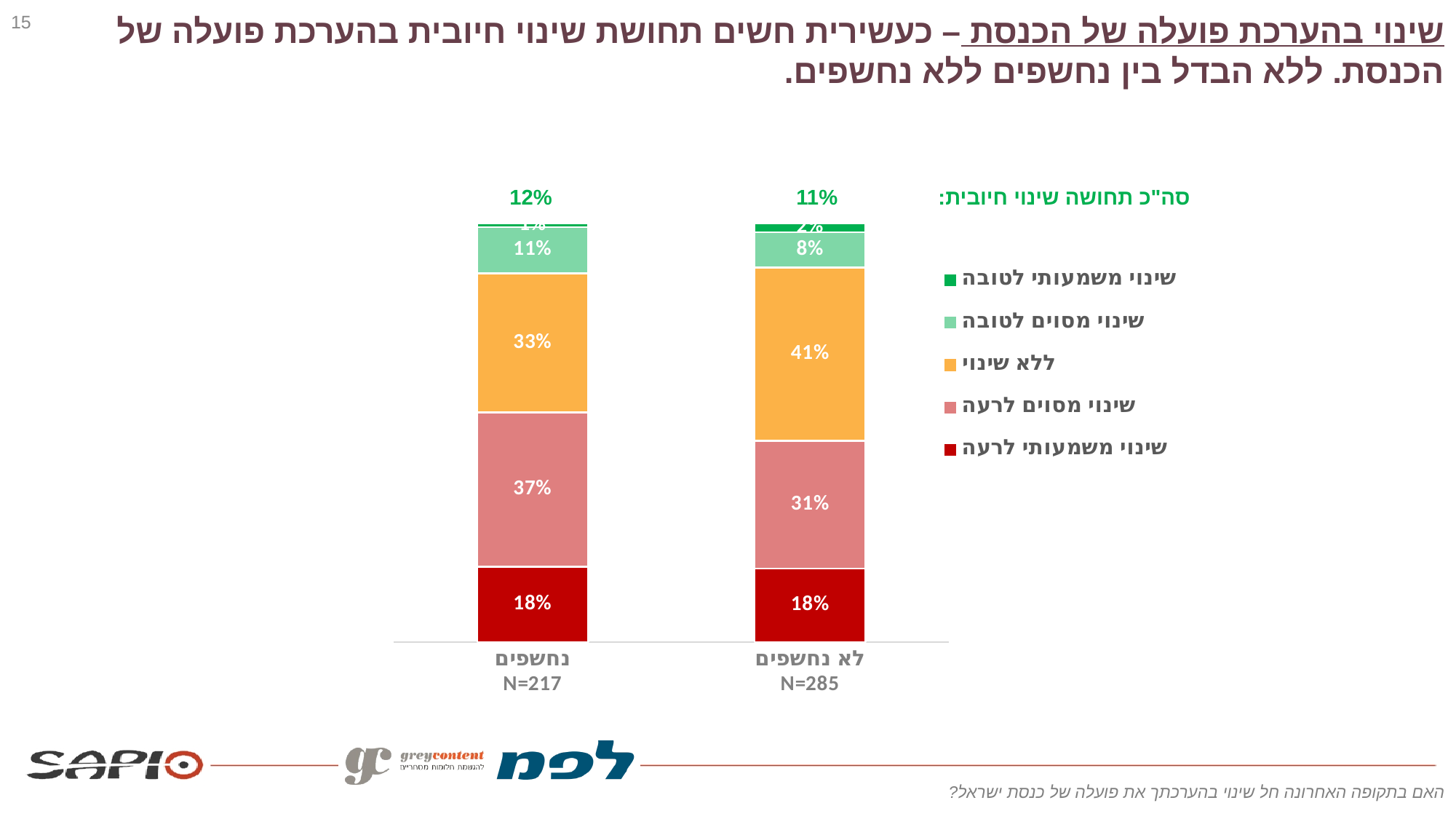
Which group has the larger value for שינוי מסוים לרעה, נחשפים or לא נחשפים? נחשפים What kind of chart is shown on the slide? stacked bar chart How many categories (bars) are shown on the x axis? 2 What is the value of שינוי מסוים לרעה for נחשפים? 37% What is the difference between the ללא שינוי values for לא נחשפים and נחשפים? 8% What is the total positive-change share (סה"כ תחושה שינוי חיובית) shown above the נחשפים bar? 12% What is the value of ללא שינוי for נחשפים? 33% What is the value of ללא שינוי for לא נחשפים? 41% What sample size (N) is shown for the לא נחשפים group? N=285 How many series does the legend list? 5 What is the value of שינוי מסוים לטובה for לא נחשפים? 8% What is the value of שינוי משמעותי לרעה for לא נחשפים? 18%